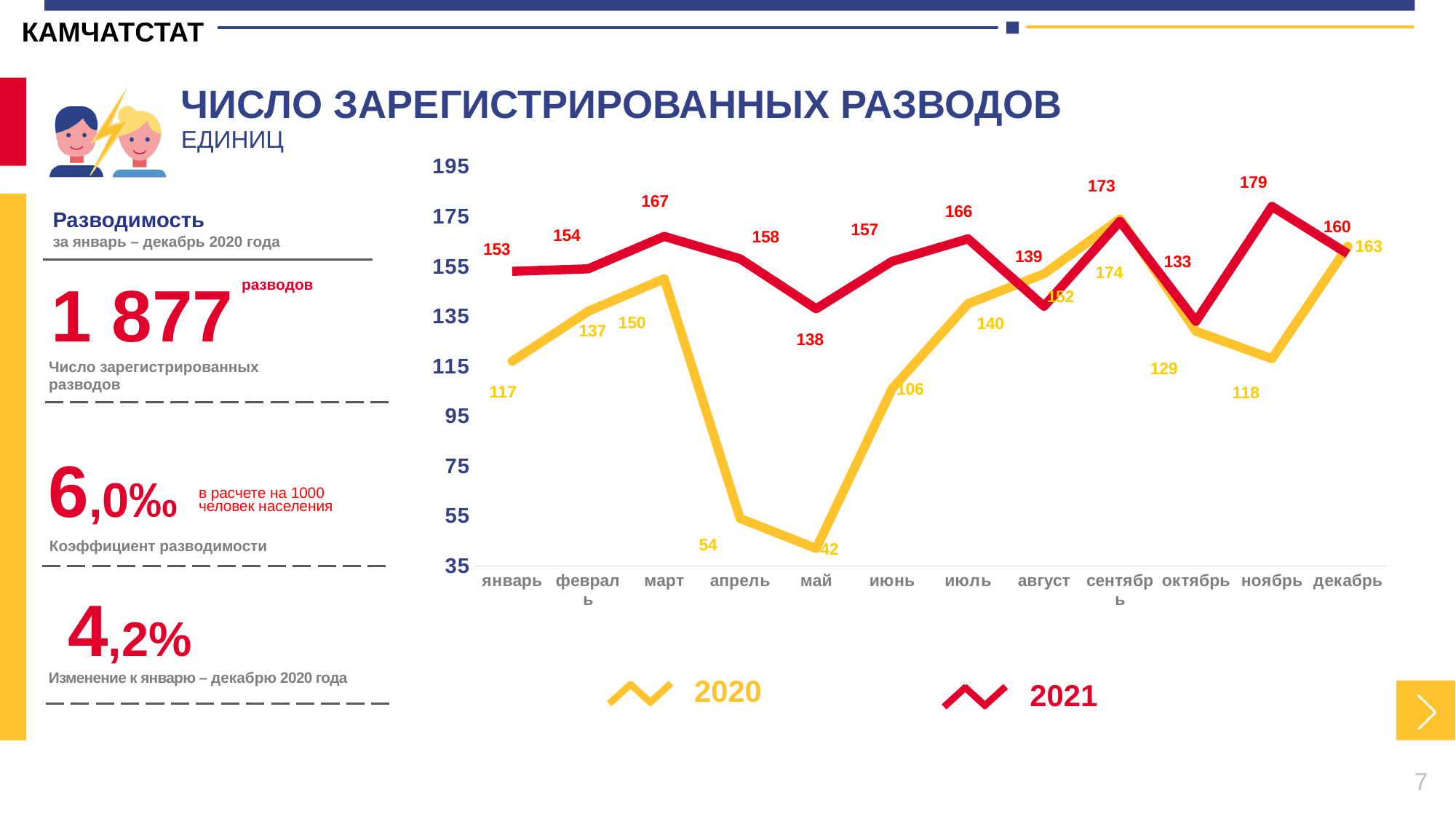
What is the difference between the 2021 and 2020 values for ноябрь (November)? 61 Which series has the larger value in апрель (April), 2020 or 2021? 2021 In which month is the 2020 series lowest? май Which colour represents the 2021 series in the chart? red What type of chart is shown on the slide? line chart How many series does the legend list? 2 What is the value for май (May) in the 2020 series? 42 In which month is the 2021 series highest? ноябрь What is the value for ноябрь (November) in the 2021 series? 179 Does the 2020 series rise or fall from март (March) to апрель (April)? fall What is the value for январь (January) in the 2020 series? 117 How many months are plotted along the x axis? 12